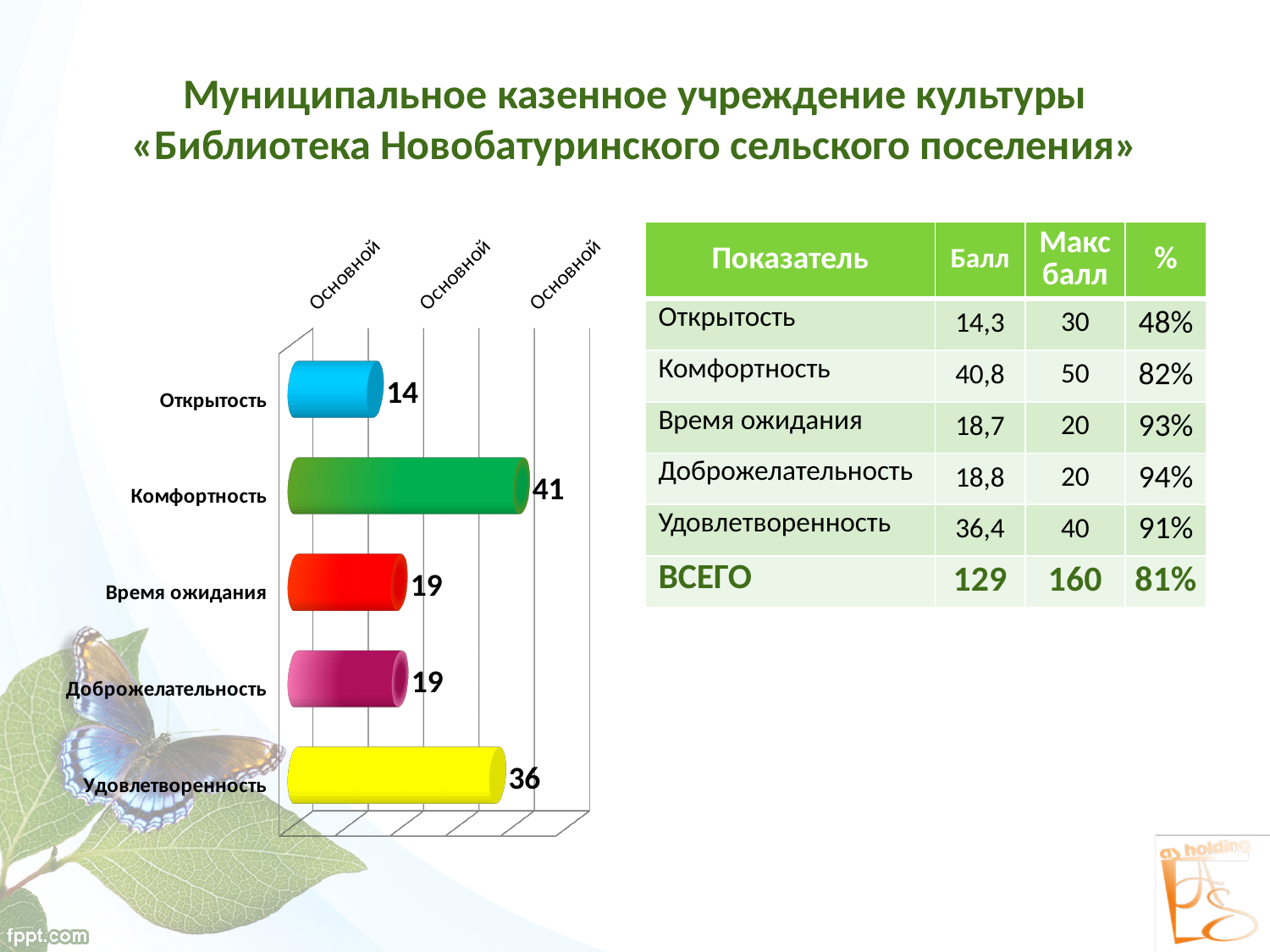
What is the difference between the values for Доброжелательность and Открытость in the chart? 5 Which category has the lowest value in the chart? Открытость Which is larger in the chart, the value for Удовлетворенность or the value for Время ожидания? Удовлетворенность What kind of chart is shown on the slide? Bar chart How many categories are shown in the chart? 5 What value does the chart show for Открытость? 14 What value does the chart show for Удовлетворенность? 36 Which category has the highest value in the chart? Комфортность What value does the chart show for Время ожидания? 19 What colour is the bar for Удовлетворенность in the chart? Yellow What value does the chart show for Комфортность? 41 What is the difference between the values for Комфортность and Удовлетворенность in the chart? 5